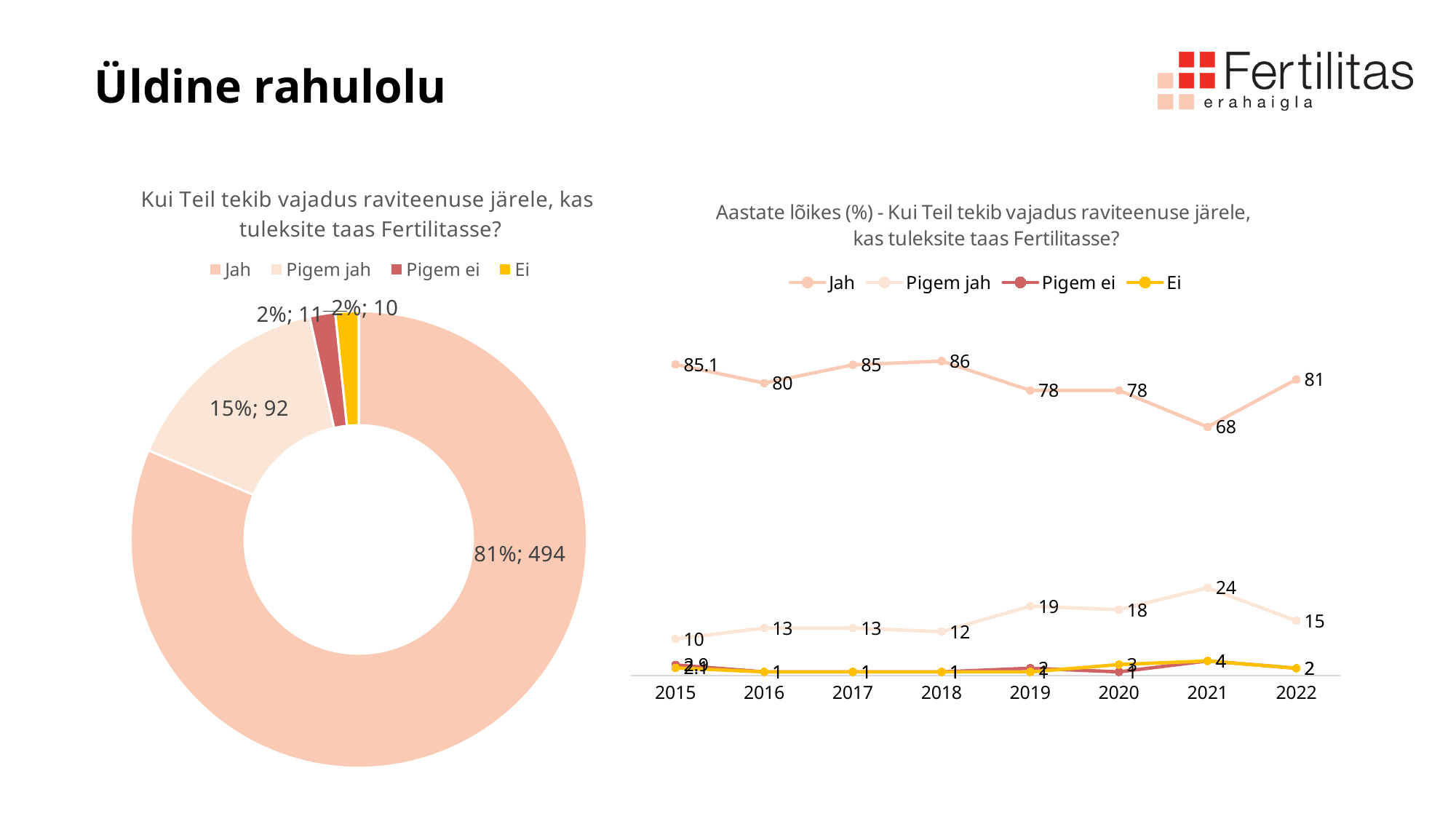
In the right line chart, what is the value of "Jah" in 2021? 68 In the left pie chart, what share of responses is "Jah"? 81% What kind of chart is the right chart titled "Aastate lõikes (%)"? line chart In the left pie chart, what count is shown for "Ei"? 10 In the right line chart, how many series does the legend list? 4 In the right line chart, what is the difference between the "Jah" values in 2018 and 2021? 18 In the left pie chart, what count is shown for "Pigem jah"? 92 In the left pie chart, which category has the largest slice? Jah In the right line chart, in which year is "Pigem jah" highest? 2021 In the right line chart, is the "Jah" value larger in 2019 or in 2022? 2022 In the right line chart, how many years are shown on the x axis? 8 What kind of chart is the left chart titled "Kui Teil tekib vajadus raviteenuse järele, kas tuleksite taas Fertilitasse?"? doughnut chart